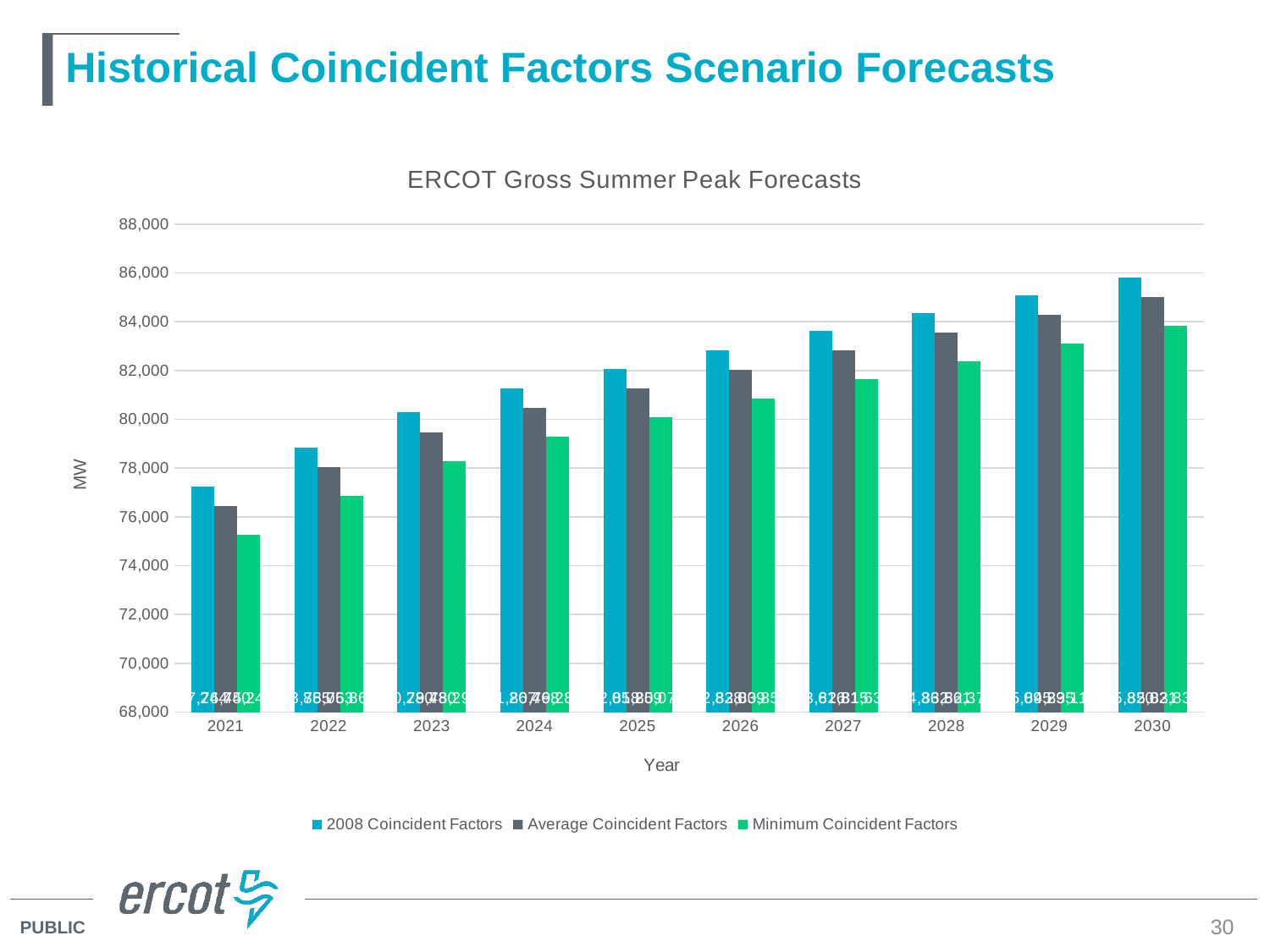
How many series does the legend list? 3 Is the value for 2008 Coincident Factors in 2030 greater or less than 84,000? greater Which year has the highest value for 2008 Coincident Factors? 2030 What is the title of the chart? ERCOT Gross Summer Peak Forecasts Which year has the lowest value for Minimum Coincident Factors? 2021 Is the value for Minimum Coincident Factors in 2024 greater or less than 80,000? less Is the value for Average Coincident Factors in 2028 greater or less than 82,000? greater How many years are shown on the x axis? 10 Do the values for Average Coincident Factors rise or fall from 2021 to 2030? rise What kind of chart is shown on the slide? Bar chart In 2021, which is larger: 2008 Coincident Factors or Minimum Coincident Factors? 2008 Coincident Factors